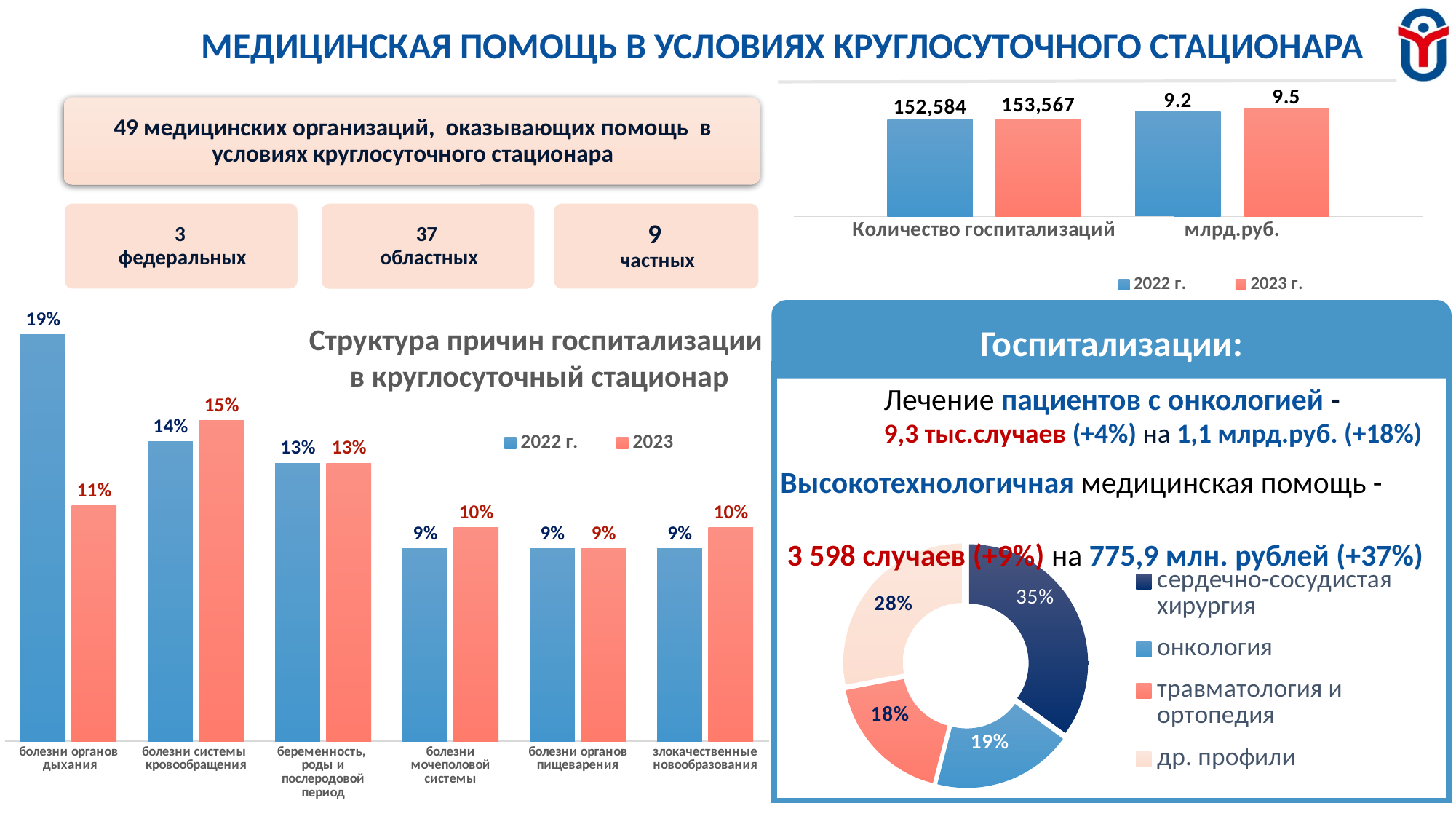
In the chart 'Структура причин госпитализации в круглосуточный стационар', what is the difference between the 2022 г. and 2023 values for болезни органов дыхания? 8% In the chart 'Структура причин госпитализации в круглосуточный стационар', what is the 2023 value for болезни системы кровообращения? 15% In the chart 'Структура причин госпитализации в круглосуточный стационар', which category has the highest 2022 г. value? болезни органов дыхания In the top-right bar chart, how many series does the legend list? 2 In the donut chart at the bottom right, what share does сердечно-сосудистая хирургия have? 35% In the top-right bar chart, what is the value for Количество госпитализаций in 2022 г.? 152,584 In the top-right bar chart, what is the difference between the 2023 г. and 2022 г. values for млрд.руб.? 0.3 In the chart 'Структура причин госпитализации в круглосуточный стационар', what kind of chart is it? bar chart In the donut chart at the bottom right, which profile has the smallest share? травматология и ортопедия In the chart 'Структура причин госпитализации в круглосуточный стационар', what is the 2022 г. value for болезни органов дыхания? 19% In the top-right bar chart, what is the value for млрд.руб. in 2023 г.? 9.5 In the chart 'Структура причин госпитализации в круглосуточный стационар', how many categories are shown on the x axis? 6